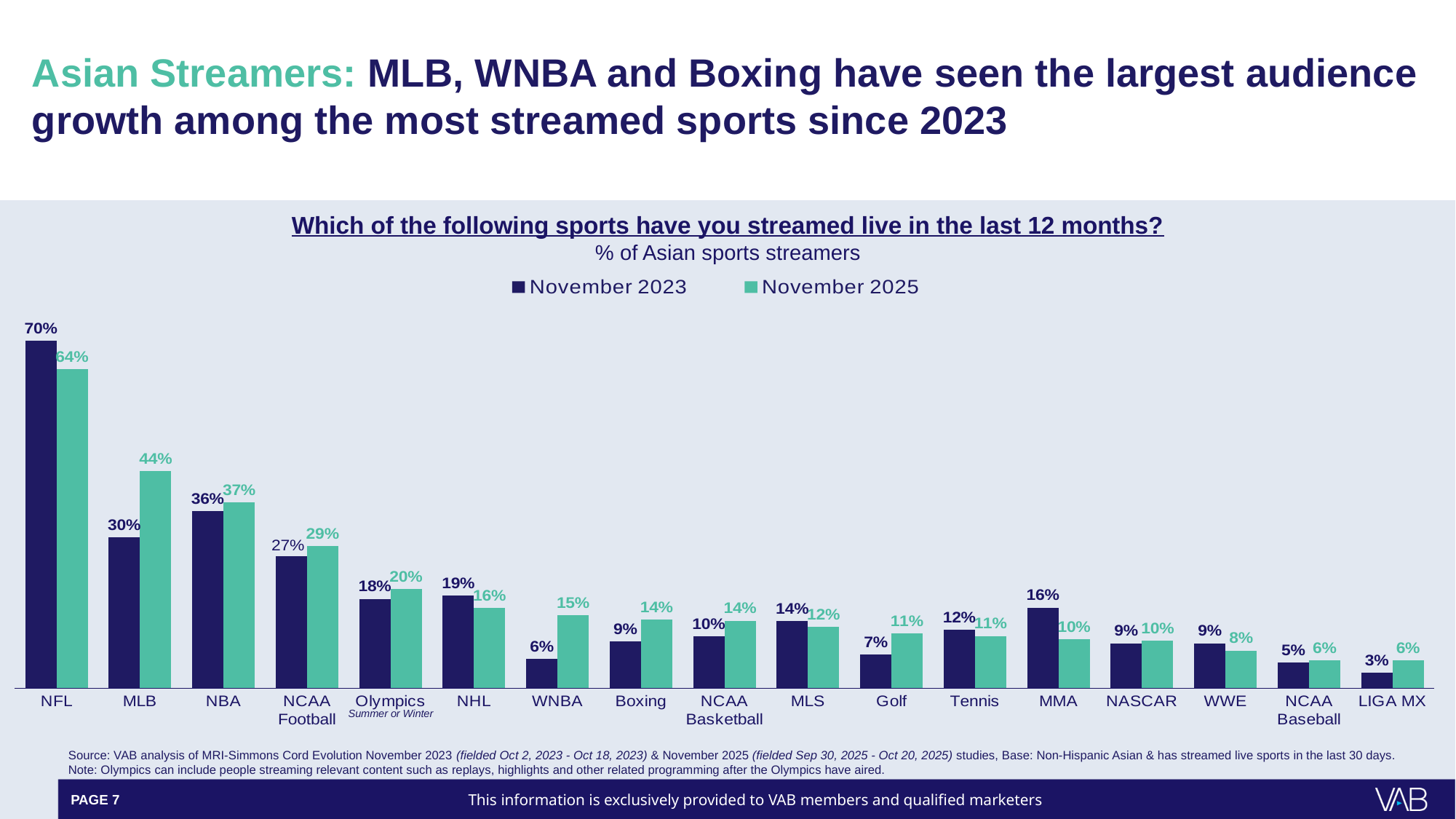
How many sports categories are shown on the x axis? 17 How many series does the legend list? 2 Which is larger for MMA: the November 2023 value or the November 2025 value? November 2023 What is the November 2025 value for MLB? 44% What are the two series named in the legend? November 2023 and November 2025 What is the November 2025 value for Boxing? 14% Which sport has the highest November 2023 value? NFL What is the difference between the November 2025 and November 2023 values for MLB? 14% What is the November 2023 value for WNBA? 6% What is the difference between the November 2023 and November 2025 values for NFL? 6% Which sport has the lowest November 2023 value? LIGA MX What kind of chart is shown on the slide? Bar chart